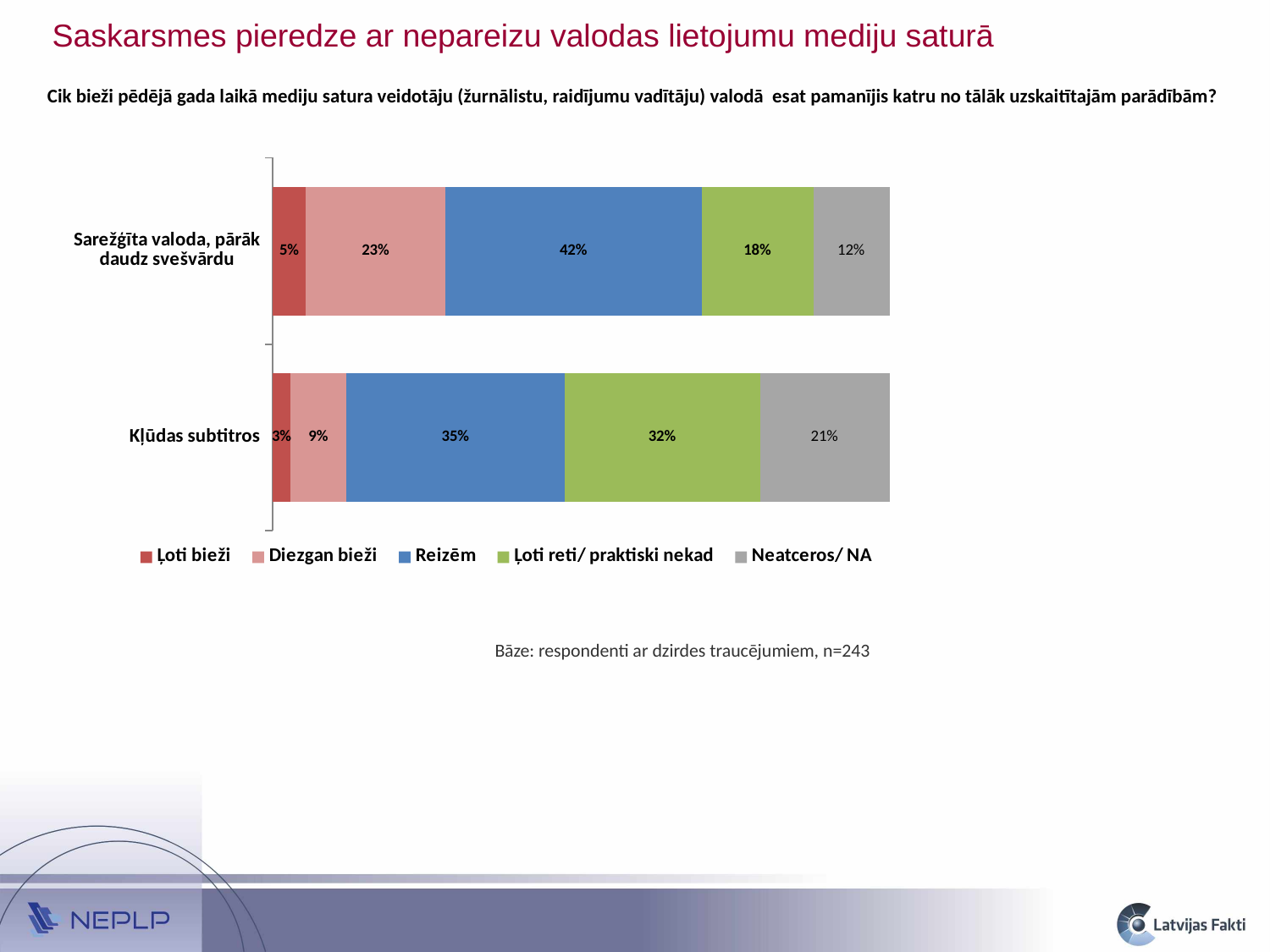
How many categories (bars) does the chart show? 2 What is the value of "Reizēm" for "Sarežģīta valoda, pārāk daudz svešvārdu"? 42% What is the first series listed in the legend? Ļoti bieži What is the value of "Ļoti reti/ praktiski nekad" for "Kļūdas subtitros"? 32% What is the value of "Neatceros/ NA" for "Kļūdas subtitros"? 21% How many series does the legend list? 5 Which series has the highest value for "Kļūdas subtitros"? Reizēm Which category has the larger "Ļoti reti/ praktiski nekad" value, "Sarežģīta valoda, pārāk daudz svešvārdu" or "Kļūdas subtitros"? Kļūdas subtitros What is the difference between the "Reizēm" values for "Sarežģīta valoda, pārāk daudz svešvārdu" and "Kļūdas subtitros"? 7% What kind of chart is shown on the slide? Stacked bar chart What is the value of "Diezgan bieži" for "Sarežģīta valoda, pārāk daudz svešvārdu"? 23% Which series has the lowest value for "Sarežģīta valoda, pārāk daudz svešvārdu"? Ļoti bieži